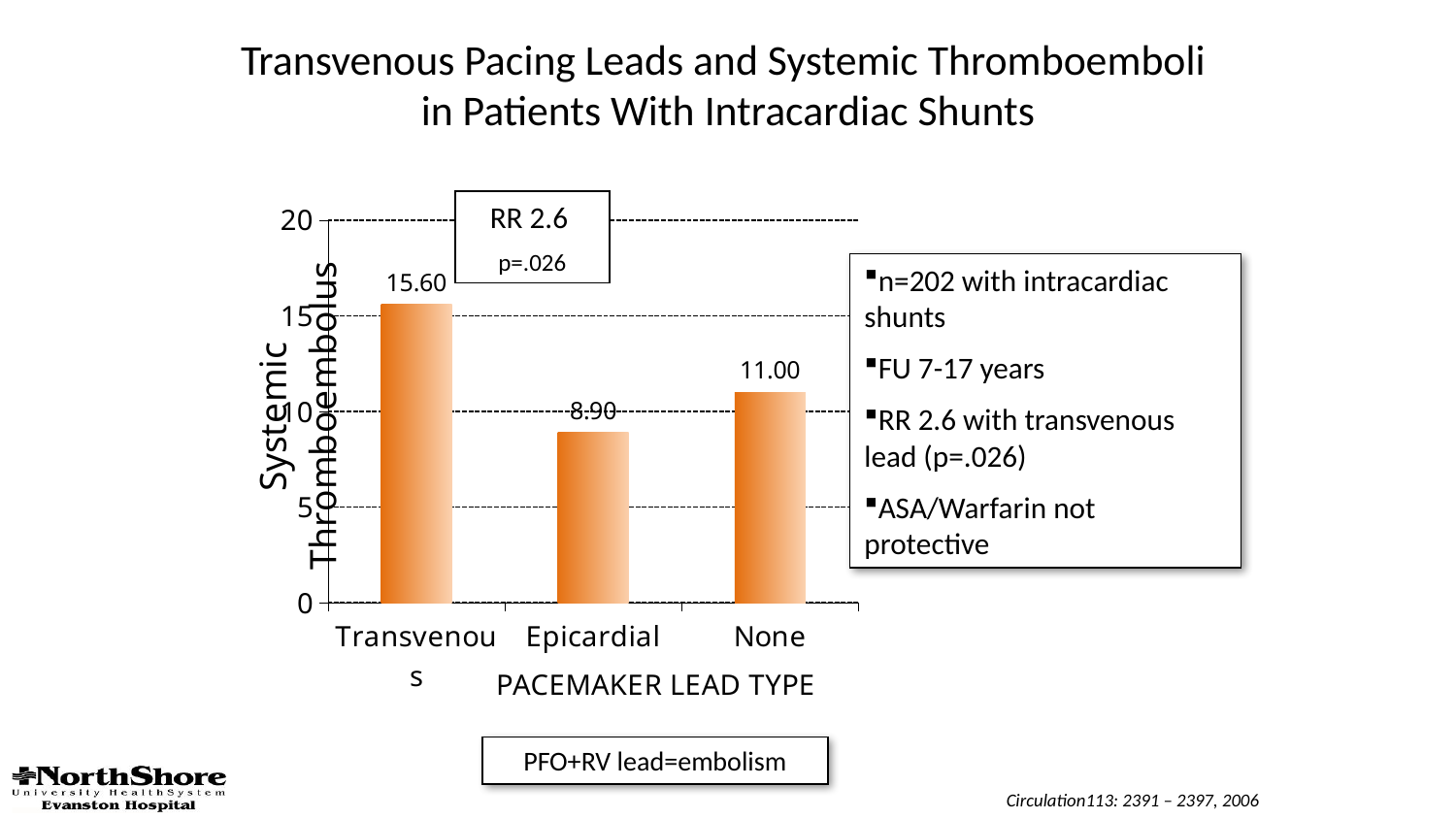
What is the value for Epicardial pacemaker lead type? 8.90 Is the value for Epicardial greater or less than 10? less What is the difference between the Transvenous and Epicardial values? 6.70 Which is larger, the value for Transvenous or the value for None? Transvenous What is the value for the None pacemaker lead type? 11.00 Which pacemaker lead type has the lowest value? Epicardial What is the difference between the None and Epicardial values? 2.10 What is the value for Transvenous pacemaker lead type? 15.60 What is the x-axis title of the chart? PACEMAKER LEAD TYPE How many pacemaker lead type categories are shown in the chart? 3 Which pacemaker lead type has the highest value? Transvenous What kind of chart is shown on the slide? bar chart